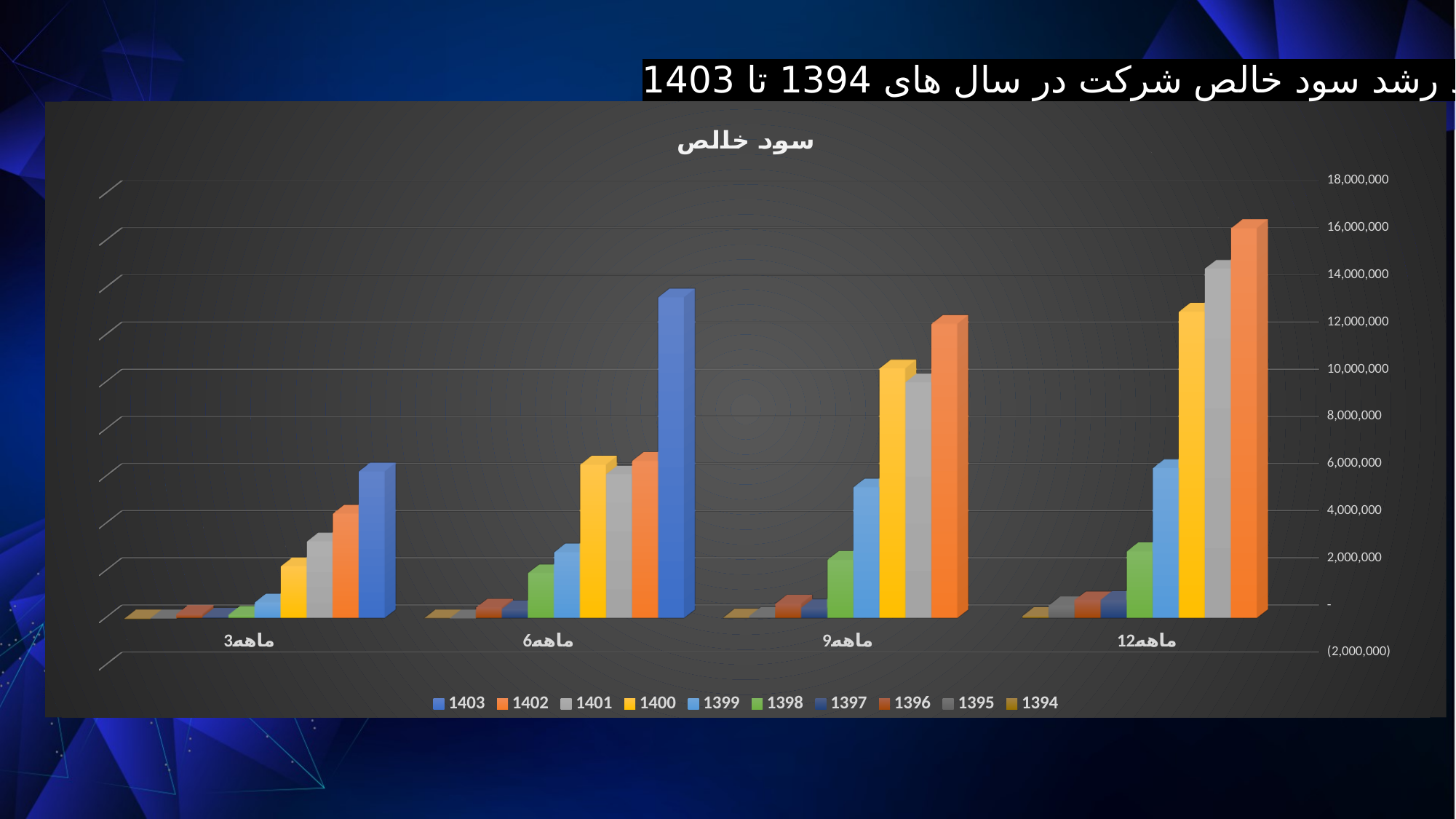
Is the value for 1403 in the 6ماهه category greater or less than 12,000,000? greater What is the title of the chart? سود خالص Which series is listed first in the chart's legend? 1403 Which series has the highest value in the 6ماهه category? 1403 How many categories are shown on the x axis of the chart? 4 Which series has the highest value in the 12ماهه category? 1402 In the 12ماهه category, which is larger: the value for 1402 or the value for 1400? 1402 What kind of chart is shown on the slide? bar chart Is the value for 1399 in the 12ماهه category greater or less than 4,000,000? greater How many series does the chart's legend list? 10 Do the values for the 1402 series rise or fall from 3ماهه to 12ماهه? rise Is the value for 1402 in the 12ماهه category greater or less than 14,000,000? greater